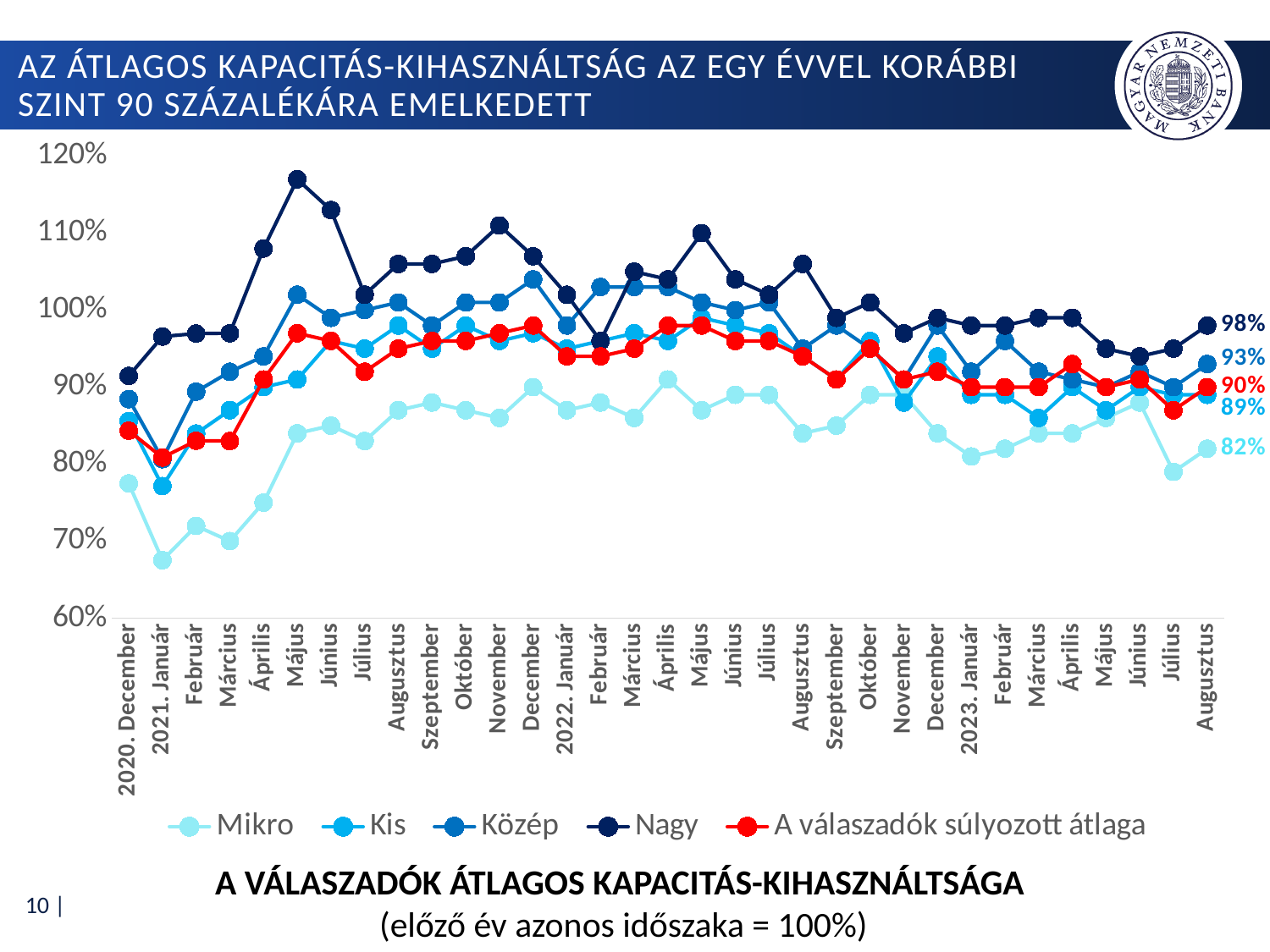
What is the difference between the Nagy and Mikro values in 2023. Augusztus? 16% What is the value for Kis in 2023. Augusztus? 89% Which series has the highest value in 2023. Augusztus? Nagy Is the value for Nagy in 2021. Május greater or less than 110%? greater How many series does the legend list? 5 Is the value for Mikro in 2021. Január greater or less than 70%? less What is the value for Nagy in 2023. Augusztus? 98% Which series has the lowest value in 2023. Augusztus? Mikro What is the value for Mikro in 2023. Augusztus? 82% What is the value for A válaszadók súlyozott átlaga in 2023. Augusztus? 90% What type of chart is shown on the slide? line chart What is the value for Közép in 2023. Augusztus? 93%